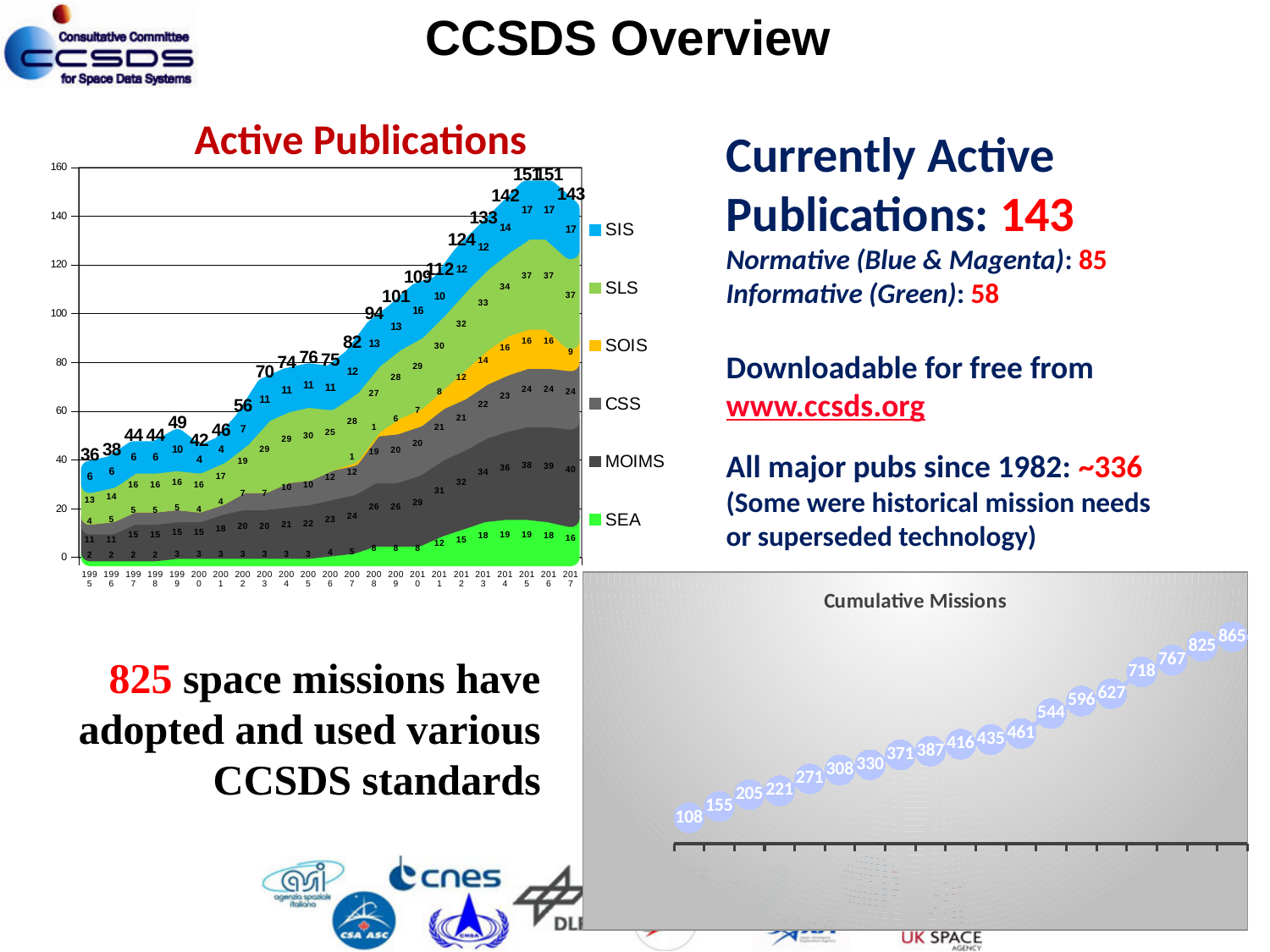
In the Active Publications chart, what is the highest total value labelled above the stacked areas? 151 In the Active Publications chart, which year has the larger total: 2002 or 2003? 2003 In the Active Publications chart, what is the value labelled for the SEA series in 2017? 16 In the Active Publications chart, what is the lowest total value labelled, shown for 1995? 36 In the Cumulative Missions chart, do the values rise or fall from left to right? rise What are the legend entries of the Active Publications chart, from top to bottom? SIS, SLS, SOIS, CSS, MOIMS, SEA In the Active Publications chart, what is the total number of active publications shown for 2017? 143 In the Cumulative Missions chart, what is the lowest value labelled? 108 In the Cumulative Missions chart, what is the highest value labelled? 865 How many data points are labelled in the Cumulative Missions chart? 19 How many series does the legend of the Active Publications chart list? 6 In the Active Publications chart, what is the difference between the total for 2016 and the total for 2017? 8